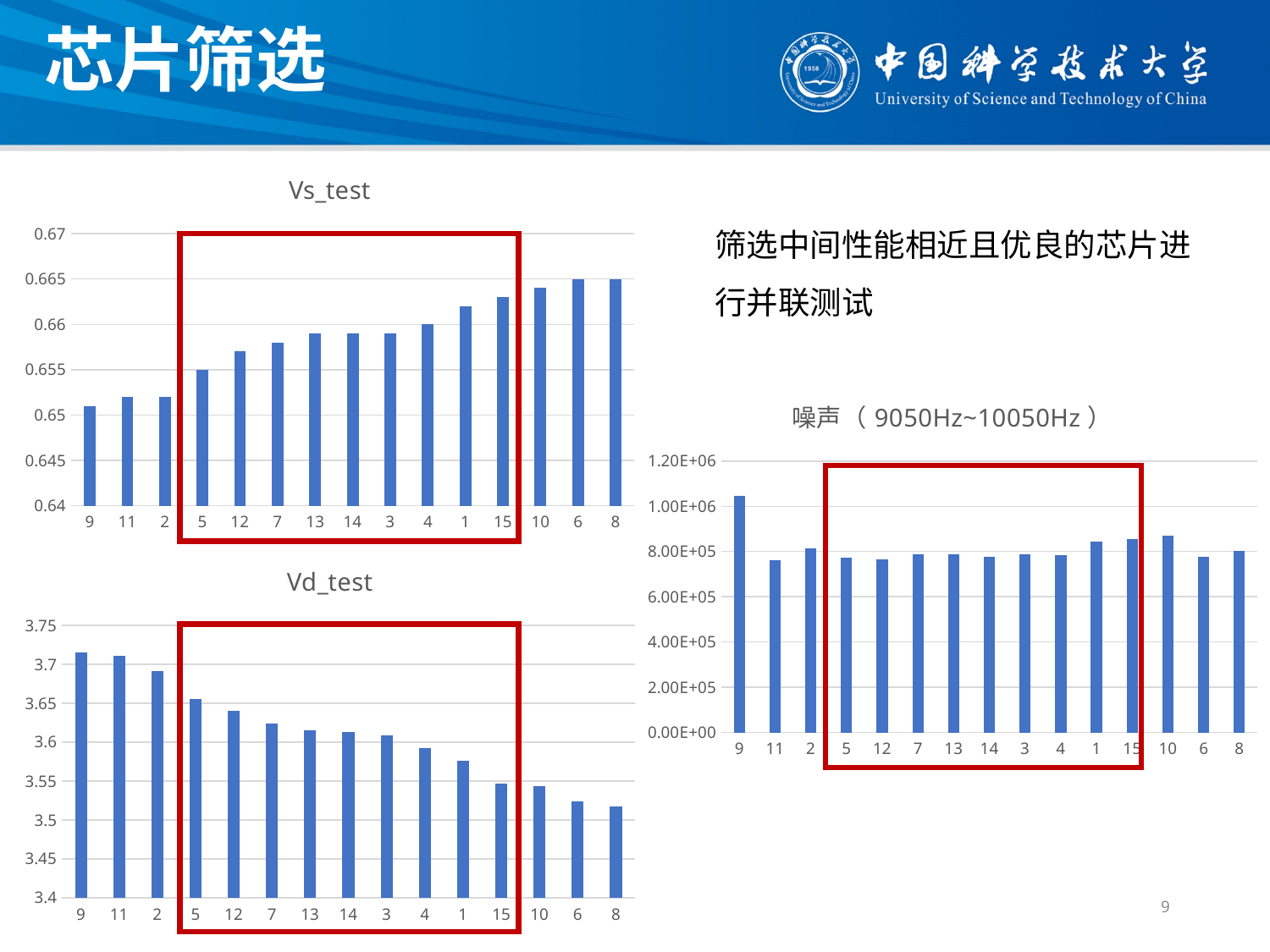
In the Vd_test chart, which has the larger value, category 9 or category 8? 9 How many bars (categories) are plotted in the Vs_test chart? 15 In the Vs_test chart, is the value for category 8 greater or less than 0.66? greater In the Vs_test chart, do the values generally rise or fall from left to right along the x axis? rise What is the title of the chart on the right side of the slide? 噪声（9050Hz~10050Hz） What kind of chart is the Vs_test chart? bar chart In the Vd_test chart, do the values generally rise or fall from left to right along the x axis? fall In the Vd_test chart, is the value for category 8 greater or less than 3.55? less In the Vd_test chart, is the value for category 9 greater or less than 3.7? greater In the 噪声（9050Hz~10050Hz）chart, which category has the highest value? 9